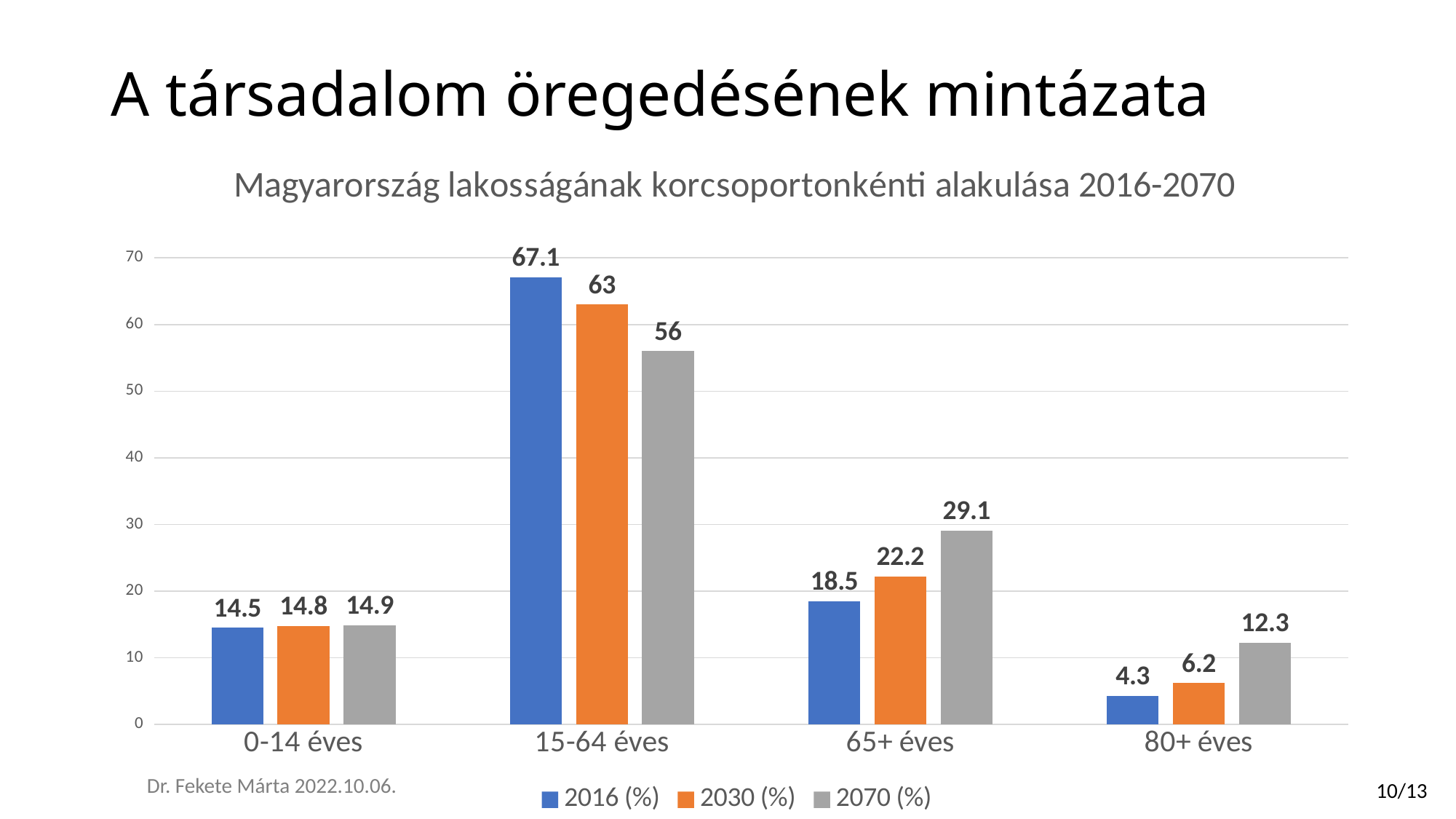
What is the value for the 80+ éves age group in the 2070 (%) series? 12.3 What kind of chart is shown on the slide? Bar chart Which is larger for the 65+ éves age group: the 2016 (%) value or the 2070 (%) value? 2070 (%) Which age group has the highest value in the 2070 (%) series? 15-64 éves How many series does the legend list? 3 What is the value for the 65+ éves age group in the 2030 (%) series? 22.2 What is the value for the 15-64 éves age group in the 2016 (%) series? 67.1 Do the values for the 65+ éves age group rise or fall from the 2016 (%) series to the 2070 (%) series? Rise What is the title of the chart? Magyarország lakosságának korcsoportonkénti alakulása 2016-2070 What is the difference between the 2016 (%) and 2070 (%) values for the 15-64 éves age group? 11.1 How many age group categories are shown on the x axis? 4 Which age group has the lowest value in the 2016 (%) series? 80+ éves